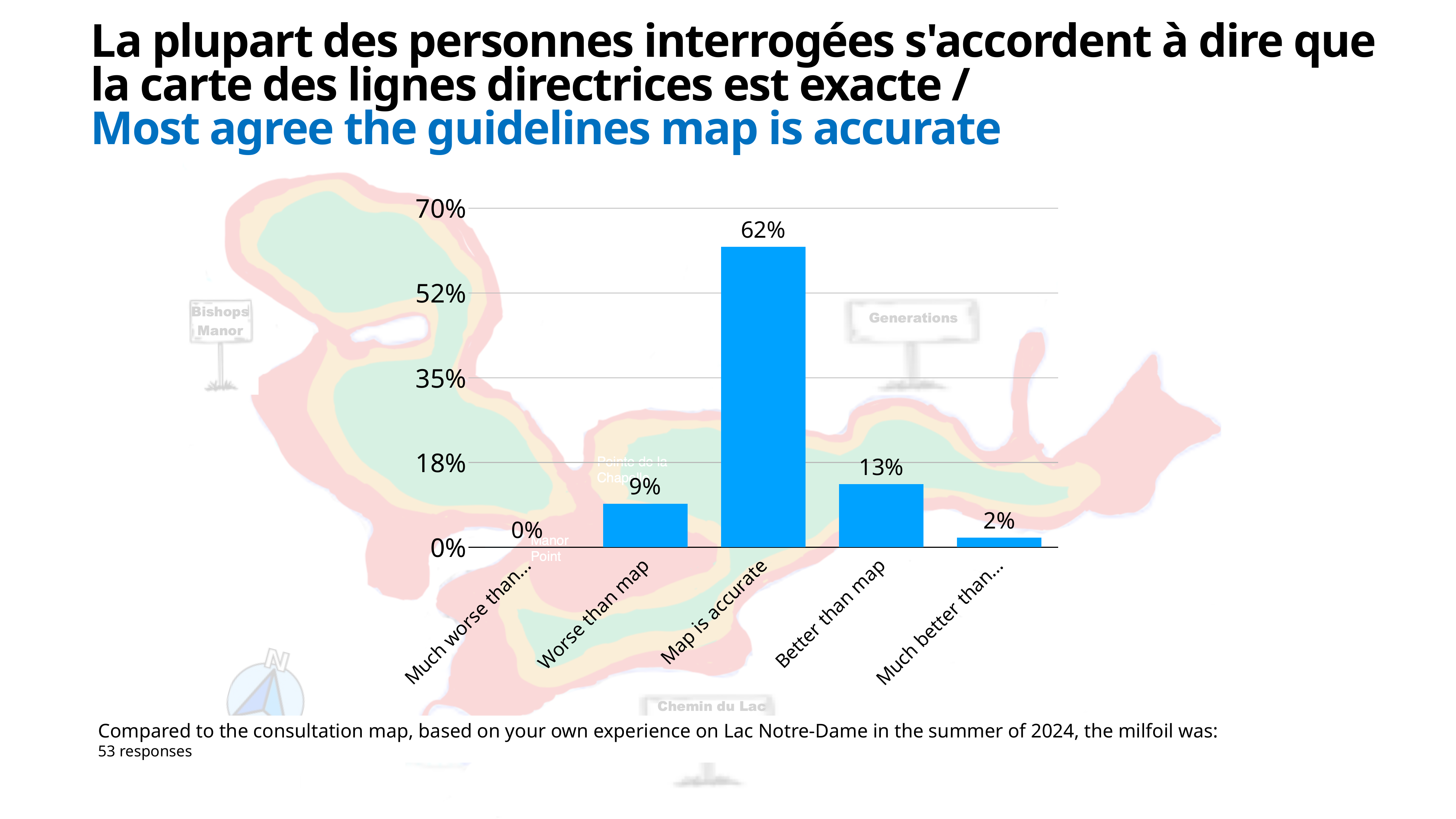
What percentage of respondents said the map is accurate? 62% Which category has the highest value? Map is accurate What percentage of respondents said the milfoil was better than the map? 13% What is the difference between the 'Map is accurate' value and the 'Better than map' value? 49% What kind of chart is shown on the slide? Bar chart What is the value shown for the 'Much worse than...' category? 0% What is the value shown for the 'Much better than...' category? 2% What percentage of respondents said the milfoil was worse than the map? 9% Which category has the lowest value? Much worse than... How many responses does the chart note say it is based on? 53 responses How many categories are shown on the x axis? 5 Which is larger, the value for 'Worse than map' or the value for 'Better than map'? Better than map